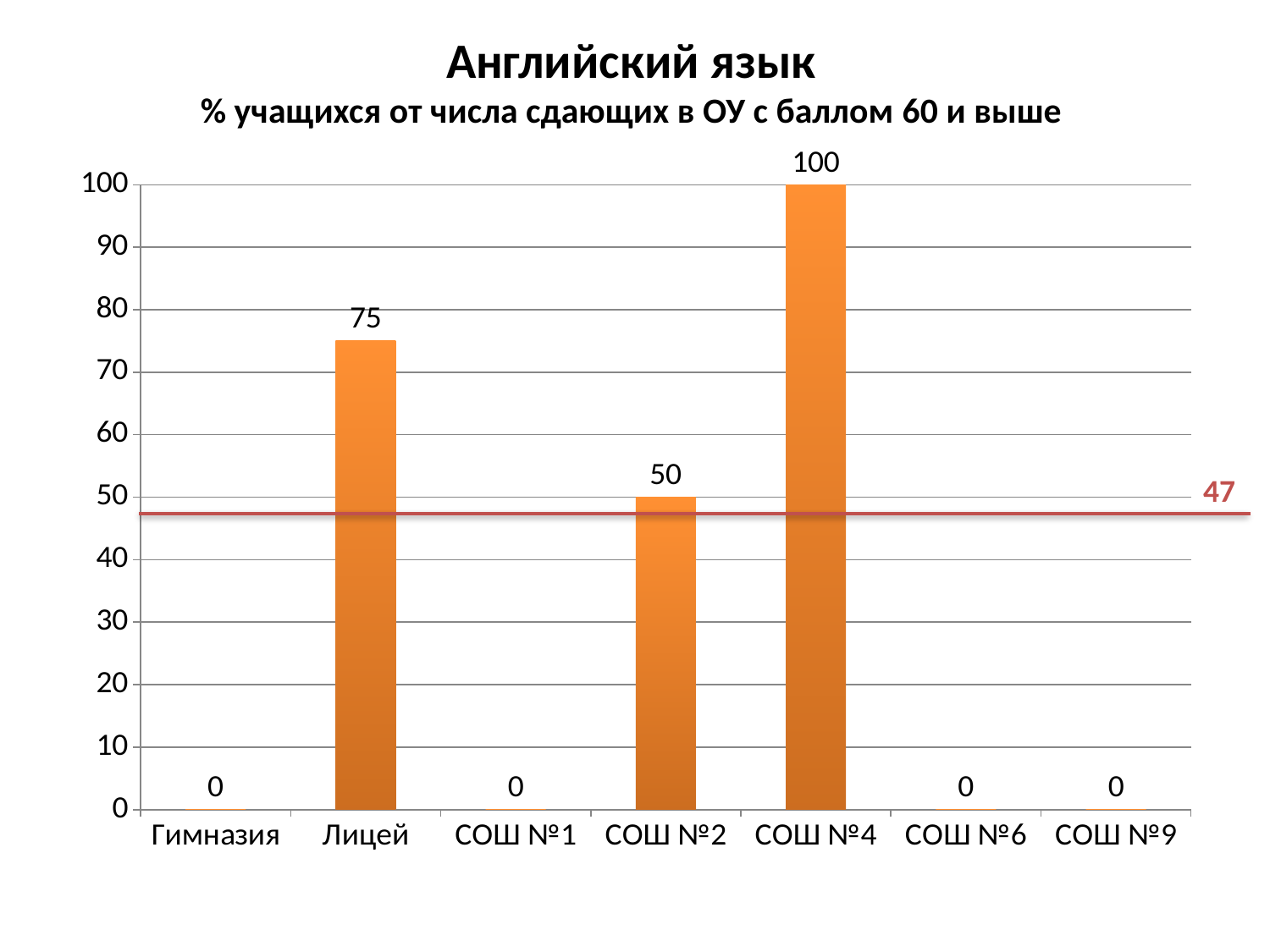
What is the difference between the values for СОШ №4 and Лицей? 25 What is the title of the chart? Английский язык What value is marked by the red horizontal line? 47 What is the value for СОШ №4? 100 How many categories have a value of 0? 4 What kind of chart is this? bar chart Which is larger, the value for Лицей or the value for СОШ №2? Лицей What is the value for СОШ №2? 50 Which category has the highest value? СОШ №4 What is the value for Лицей? 75 What is the value for Гимназия? 0 How many categories are shown on the x axis? 7